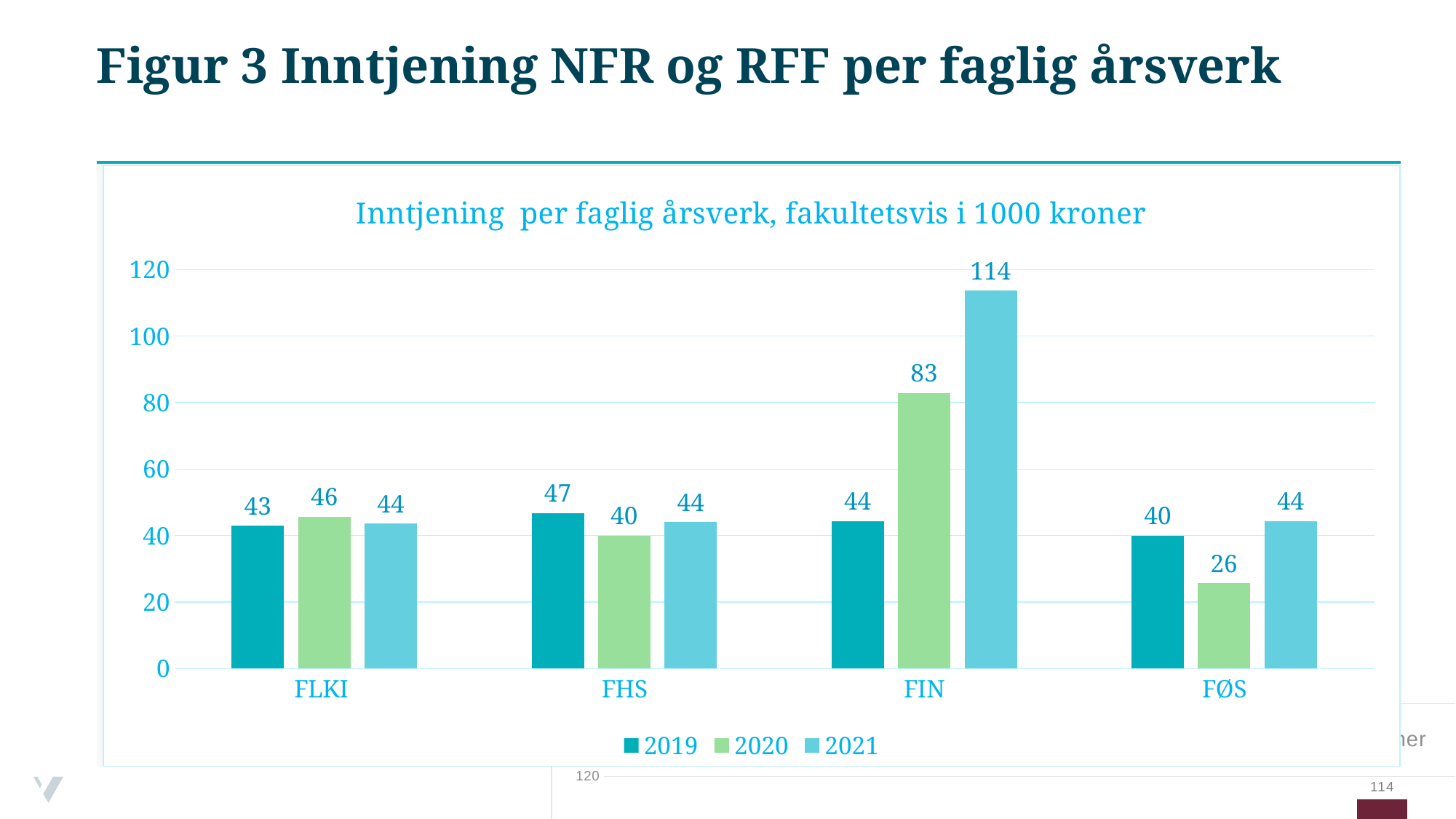
Which faculty has the lowest value in 2020? FØS What kind of chart is shown? bar chart How many series does the legend list? 3 What is the value for FHS in 2019? 47 What is the difference between the 2021 and 2020 values for FIN? 31 Is the value for FIN in 2021 greater or less than 100? greater Which is larger, the 2020 value for FLKI or the 2020 value for FHS? FLKI Which faculty has the highest value in 2021? FIN What is the value for FIN in 2021? 114 What is the value for FØS in 2020? 26 How many faculties are shown on the x axis? 4 What is the title of the chart? Inntjening per faglig årsverk, fakultetsvis i 1000 kroner